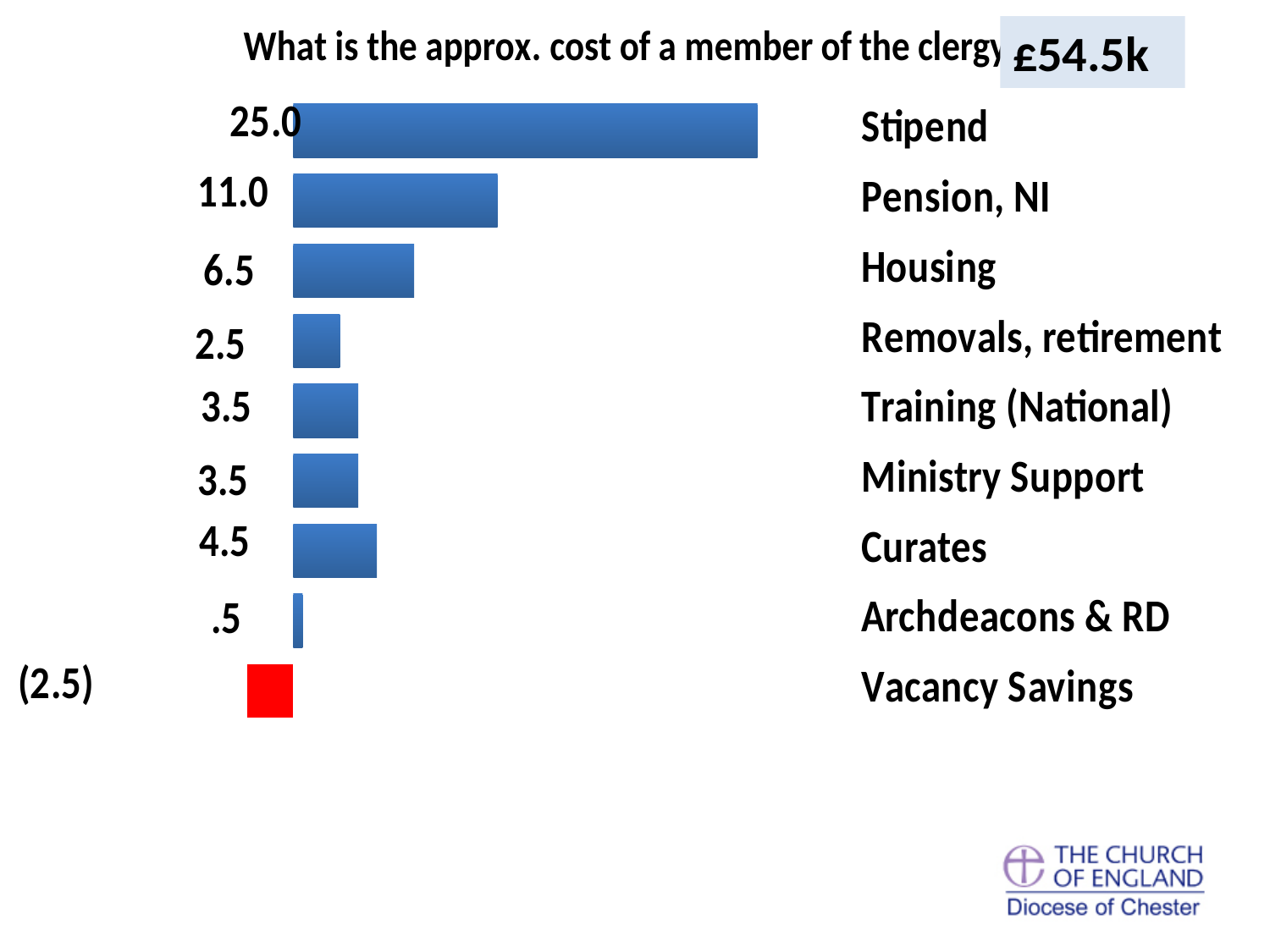
What kind of chart is shown on the slide? Bar chart What is the value shown for Pension, NI? 11.0 What is the value shown for Vacancy Savings? (2.5) What is the value shown for Stipend? 25.0 Which category has the largest bar? Stipend What is the difference between the Stipend value and the Pension, NI value? 14.0 Which is larger, the value for Curates or the value for Training (National)? Curates Which category has the smallest positive value? Archdeacons & RD How many categories are shown in the chart? 9 What is the value shown for Housing? 6.5 What is the value shown for Curates? 4.5 Which category is drawn with a red bar? Vacancy Savings